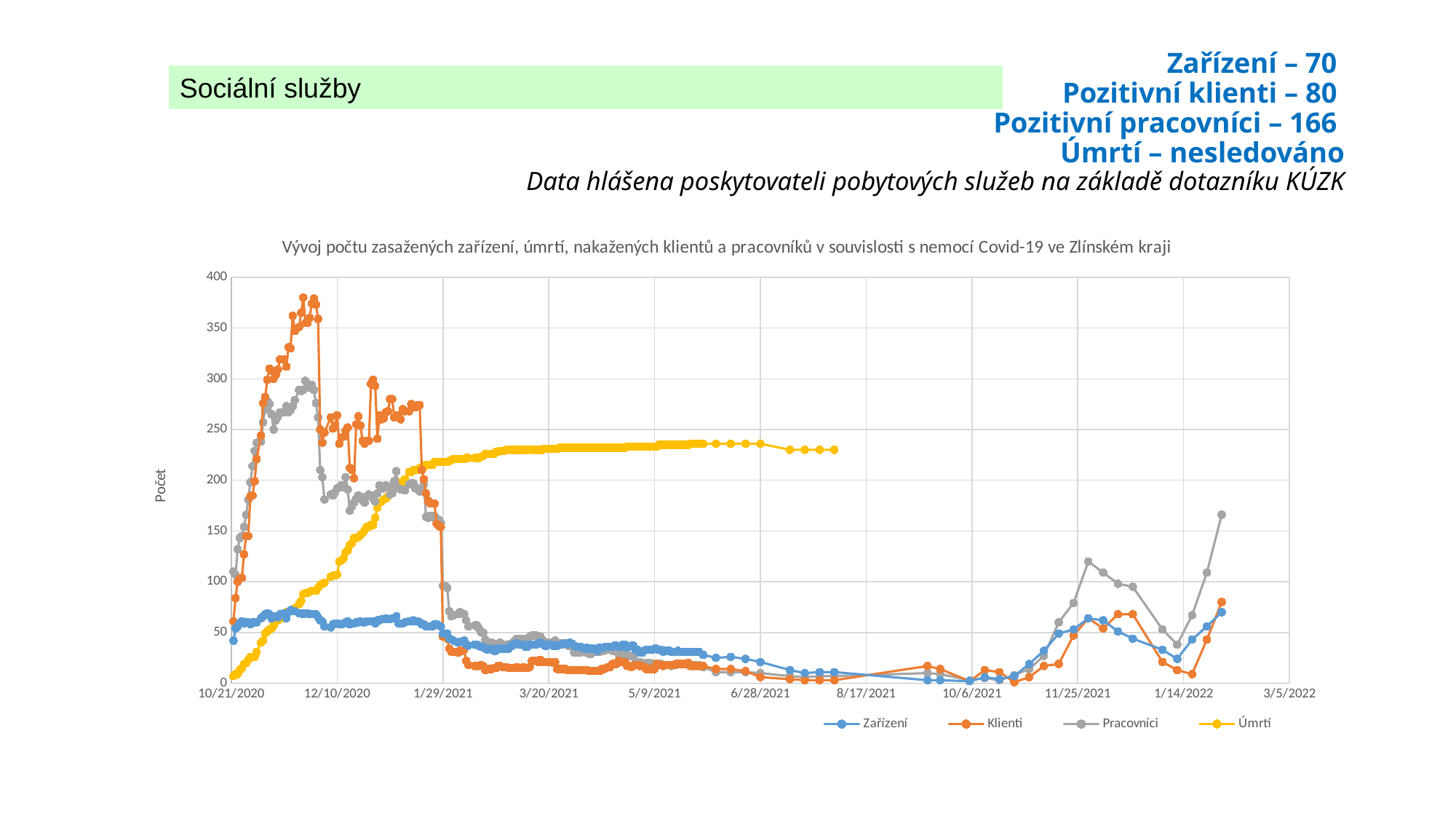
Between 1/29/2021 and 3/20/2021, does the Klienti series rise or fall? fall Is the value of the Pracovníci series at 1/14/2022 greater or less than 100? less Does the Úmrtí series generally rise or fall from 10/21/2020 to its last point? rise Which series reaches the highest value anywhere on the chart? Klienti Is the value of the Úmrtí series at 6/28/2021 greater or less than 200? greater What is the label on the vertical axis of the chart? Počet Is the value of the Zařízení series at 10/6/2021 greater or less than 50? less What kind of chart is shown on the slide? line chart What are the series names listed in the chart's legend? Zařízení, Klienti, Pracovníci, Úmrtí How many series does the chart's legend list? 4 Around 12/10/2020, which series has the larger value, Klienti or Zařízení? Klienti